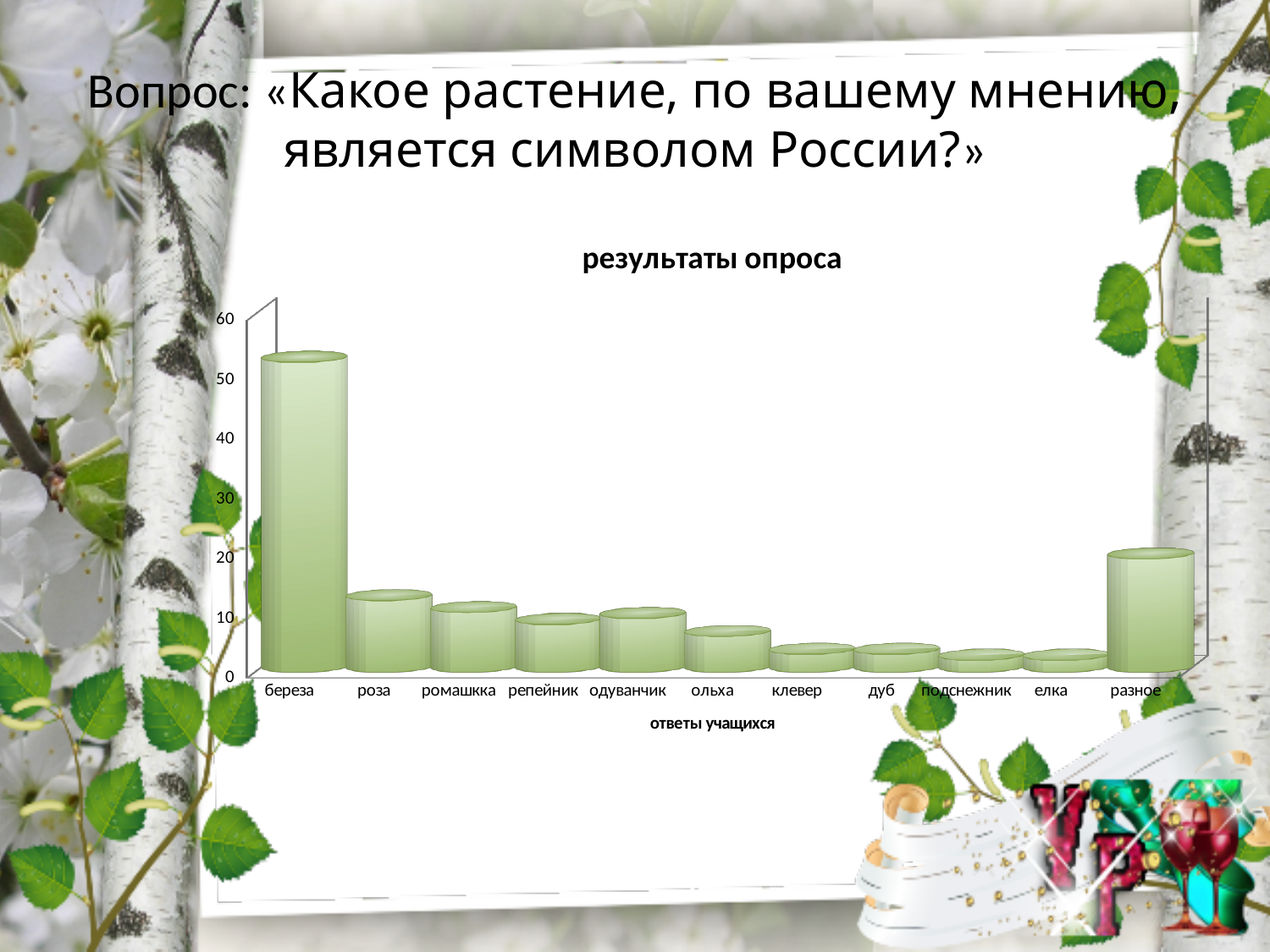
What kind of chart is shown on the slide? bar chart Is the value for разное greater or less than 10? greater How many categories are shown on the horizontal axis of the chart? 11 Is the value for береза greater or less than 40? greater Which has a larger value, разное or роза? разное Which category has the highest value in the chart? береза Which has a larger value, роза or клевер? роза What is the title of the chart? результаты опроса Which has a larger value, береза or разное? береза Is the value for ольха greater or less than 10? less What is the label of the horizontal axis of the chart? ответы учащихся